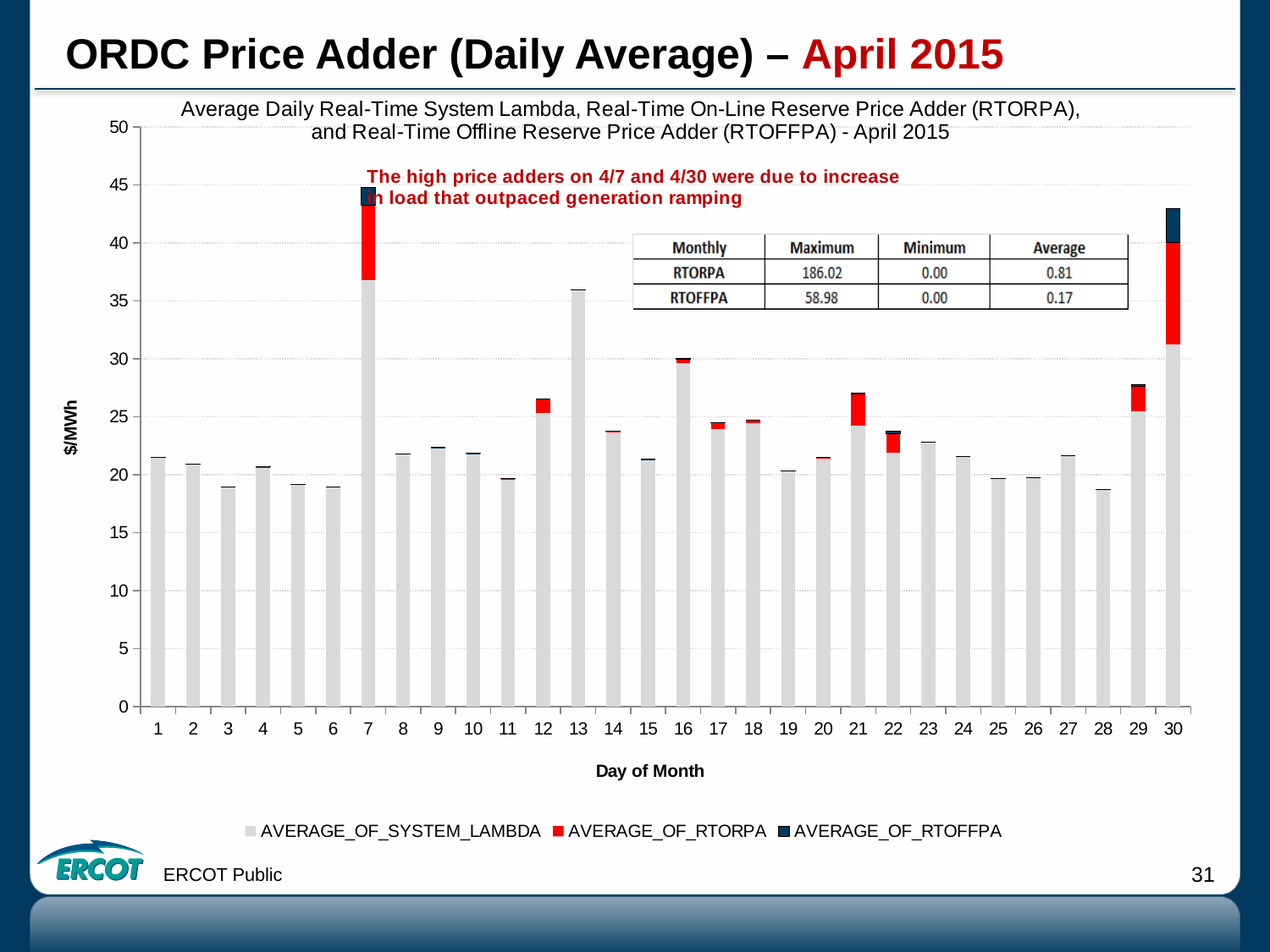
According to the table on the chart, what is the monthly maximum of RTORPA? 186.02 According to the table on the chart, what is the monthly average of RTOFFPA? 0.17 Which day of the month has the highest total bar? 7 What kind of chart is shown on the slide? bar chart Is the total bar for day 7 greater or less than 40? greater Is the total bar for day 13 greater or less than 30? greater Is the total bar for day 30 greater or less than 40? greater Which has the larger total bar, day 13 or day 12? day 13 How many days of the month are plotted on the x axis? 30 What is the label on the y axis of the chart? $/MWh How many series does the chart legend list? 3